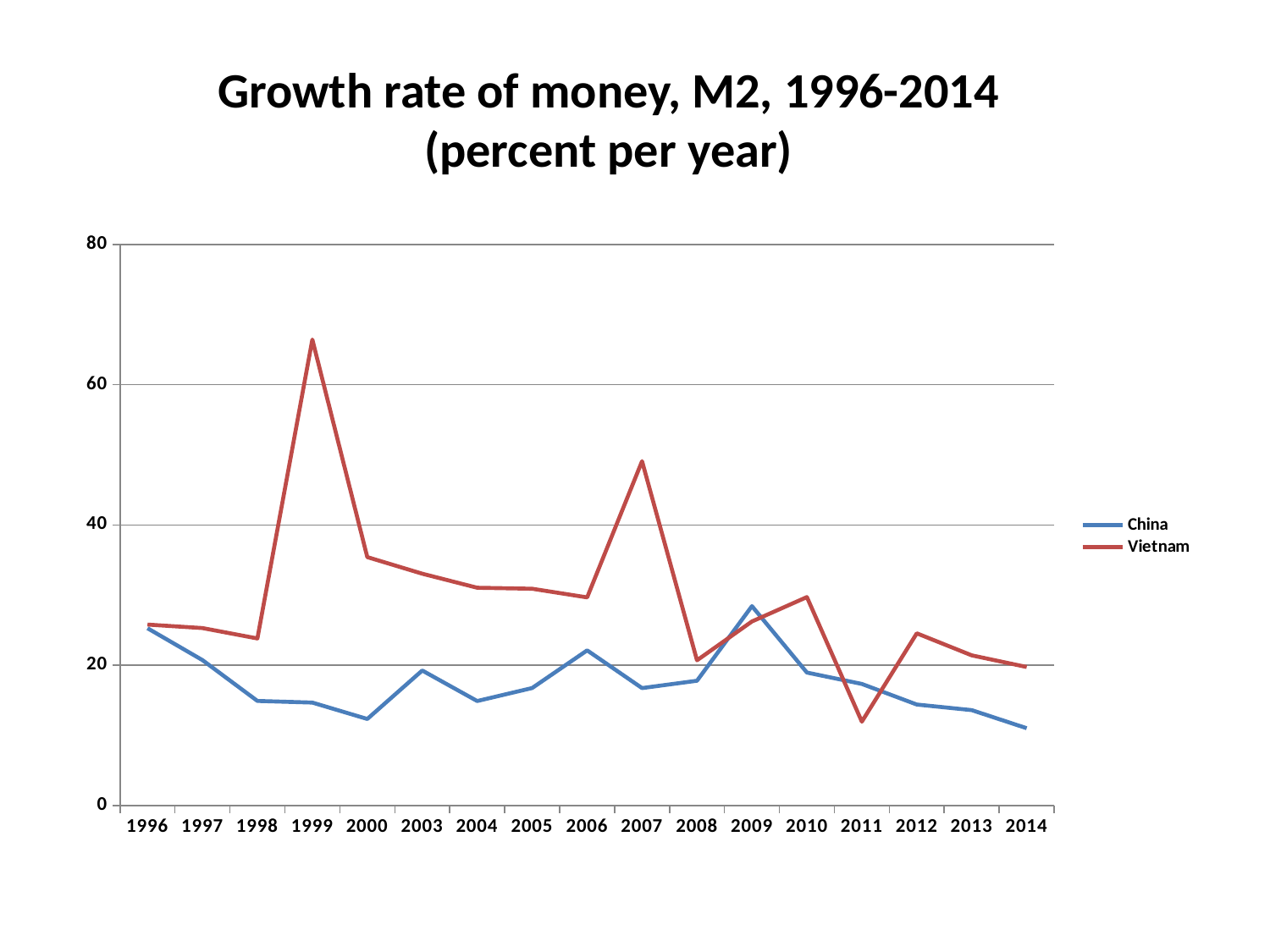
In which year is Vietnam's M2 growth rate lowest? 2011 In which year is China's M2 growth rate lowest? 2014 Is the value for China in 2000 greater or less than 20? less Is the value for Vietnam in 2007 greater or less than 40? greater Is the value for Vietnam in 1999 greater or less than 60? greater What kind of chart is shown on the slide? line chart How many years are plotted along the x axis? 17 How many series does the legend list? 2 Does China's M2 growth rate rise or fall from 2009 to 2014? fall In 2010, which country has the higher M2 growth rate, China or Vietnam? Vietnam In which year does Vietnam reach its highest M2 growth rate? 1999 In which year does China reach its highest M2 growth rate? 2009